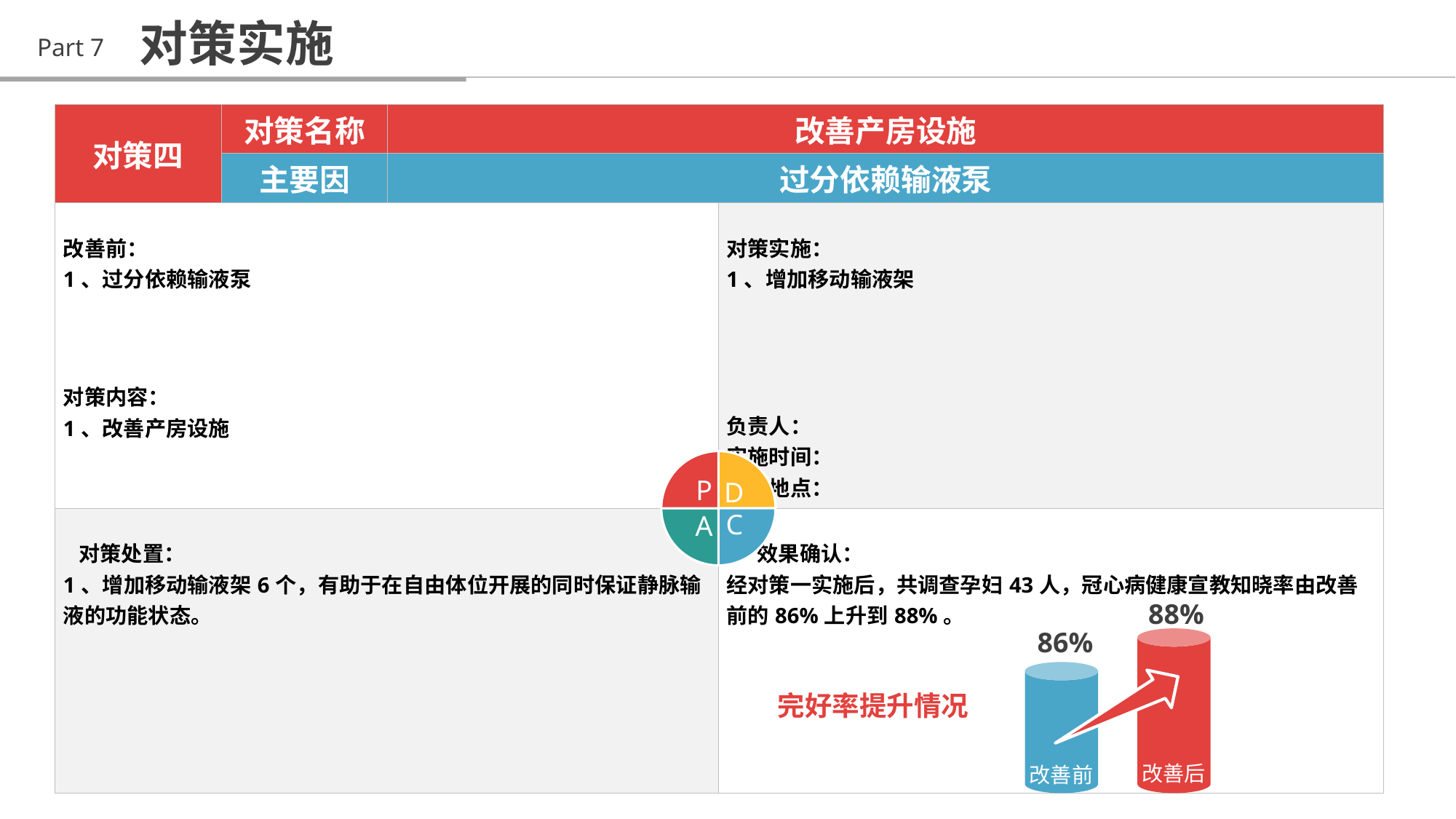
What is the value for 改善后 in the chart? 88% What is the difference between the values for 改善后 and 改善前? 2% How many categories are shown in the chart? 2 Which category has the lower value in the chart? 改善前 What is the title of the chart? 完好率提升情况 What colour is the bar for 改善后? red Is the value for 改善后 larger or smaller than the value for 改善前? larger What is the value for 改善前 in the chart? 86% Do the values rise or fall from 改善前 to 改善后? rise Which category has the higher value in the chart? 改善后